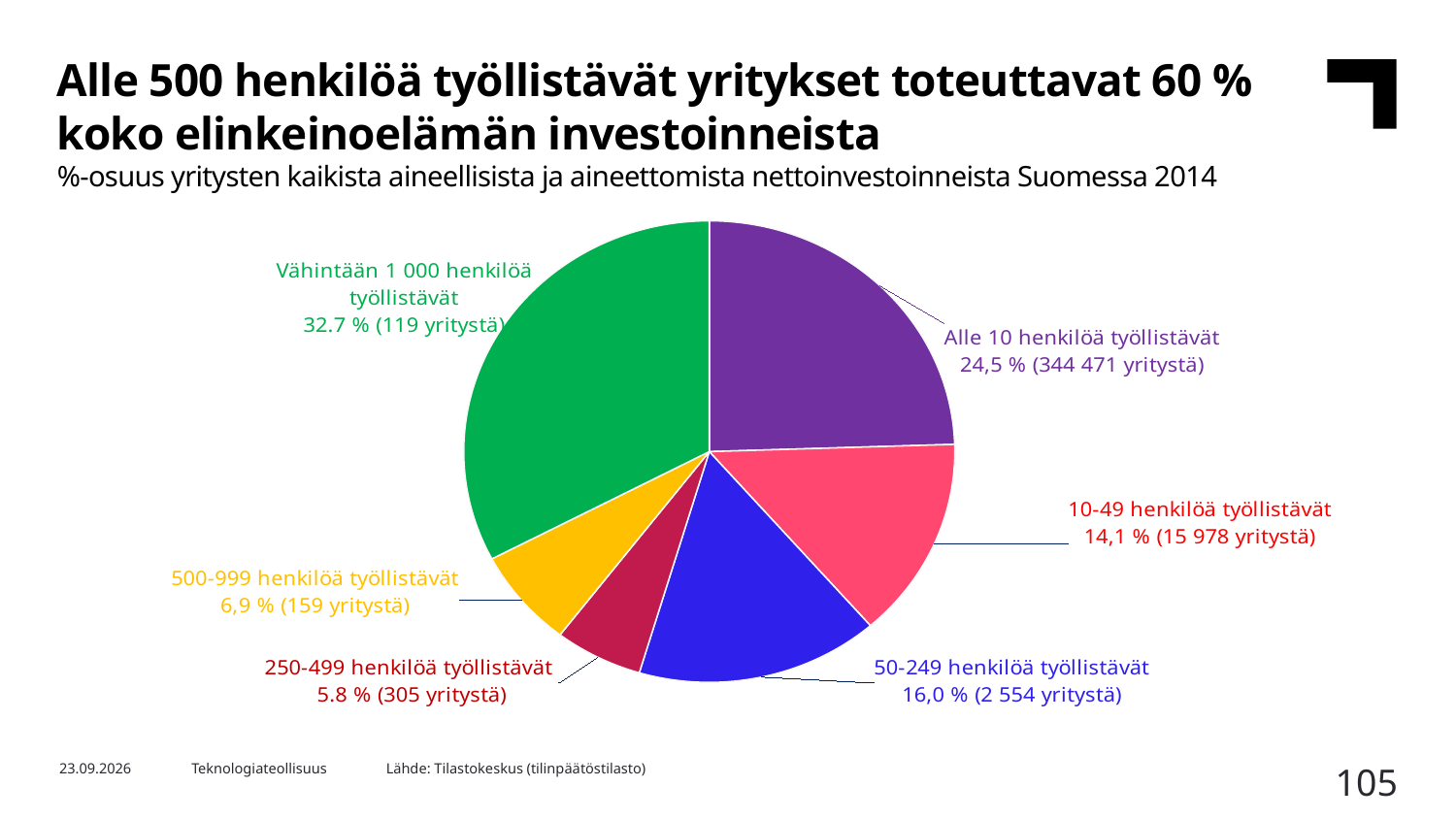
What share of net investments is attributed to companies employing at least 1 000 people (Vähintään 1 000 henkilöä työllistävät)? 32.7 % How many slices does the pie chart have? 6 Which company size group has the largest share of the pie? Vähintään 1 000 henkilöä työllistävät Which slice is larger: 10-49 henkilöä työllistävät or 50-249 henkilöä työllistävät? 50-249 henkilöä työllistävät Which company size group has the smallest share of the pie? 250-499 henkilöä työllistävät What colour is the slice for Alle 10 henkilöä työllistävät? purple How many companies are in the 500-999 henkilöä työllistävät group according to the label? 159 What percentage is shown for the 50-249 henkilöä työllistävät slice? 16,0 % What kind of chart is shown on the slide? pie chart What percentage is shown for companies employing fewer than 10 people (Alle 10 henkilöä työllistävät)? 24,5 % How many companies are in the 10-49 henkilöä työllistävät group according to the label? 15 978 What is the difference in percentage points between the 500-999 henkilöä työllistävät slice (6,9 %) and the 250-499 henkilöä työllistävät slice (5.8 %)? 1.1 percentage points